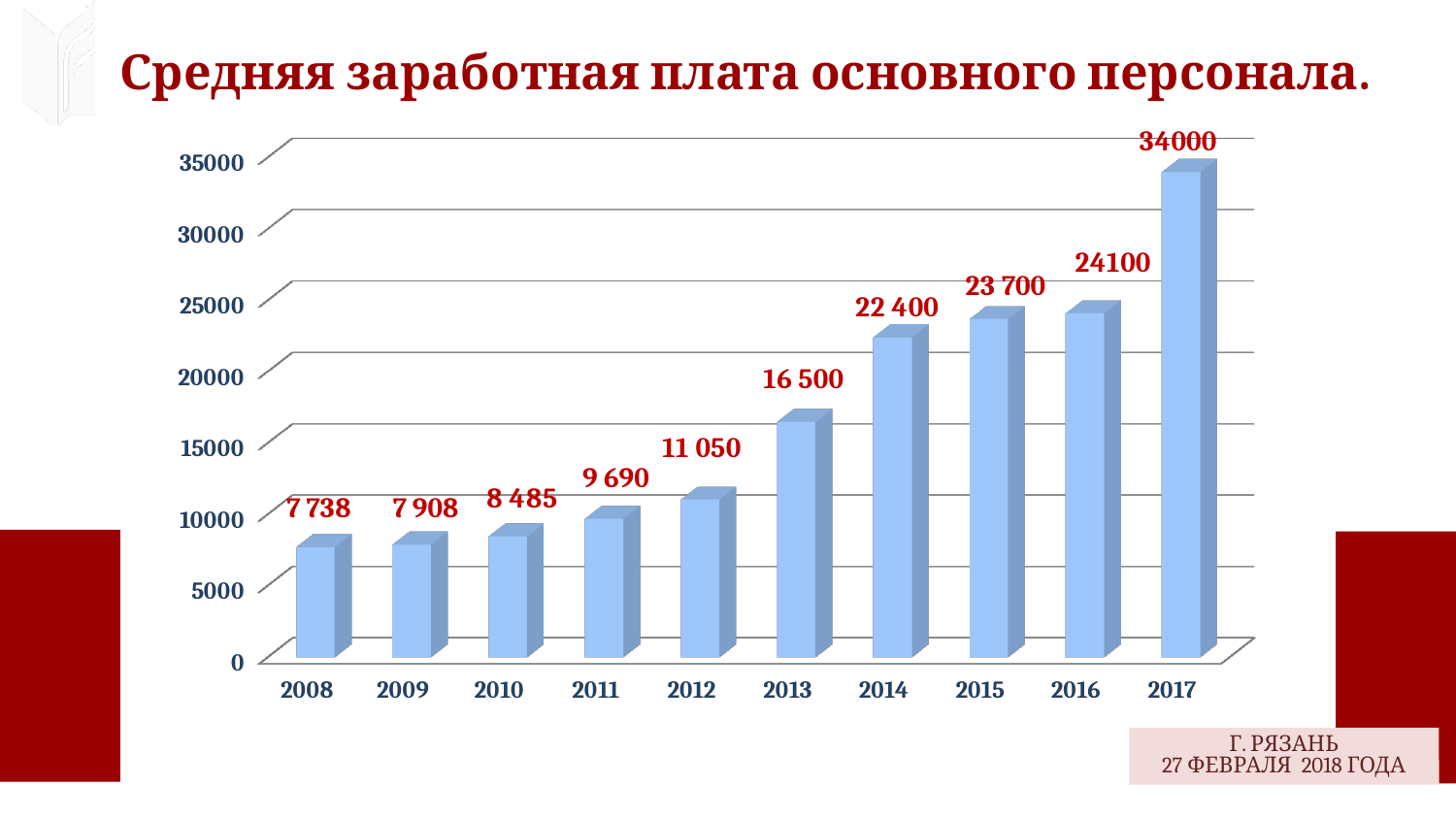
What is the value for 2008? 7 738 What is the value for 2016? 24100 Which year has the lowest value? 2008 Which year has the highest value? 2017 What kind of chart is shown on the slide? bar chart Which is larger, the value for 2012 or the value for 2011? 2012 What is the value for 2013? 16 500 Do the values rise or fall from 2008 to 2017? rise What is the difference between the values for 2014 and 2013? 5 900 How many years are shown on the x axis? 10 What is the difference between the values for 2017 and 2016? 9900 Is the value for 2015 greater or less than 20000? greater